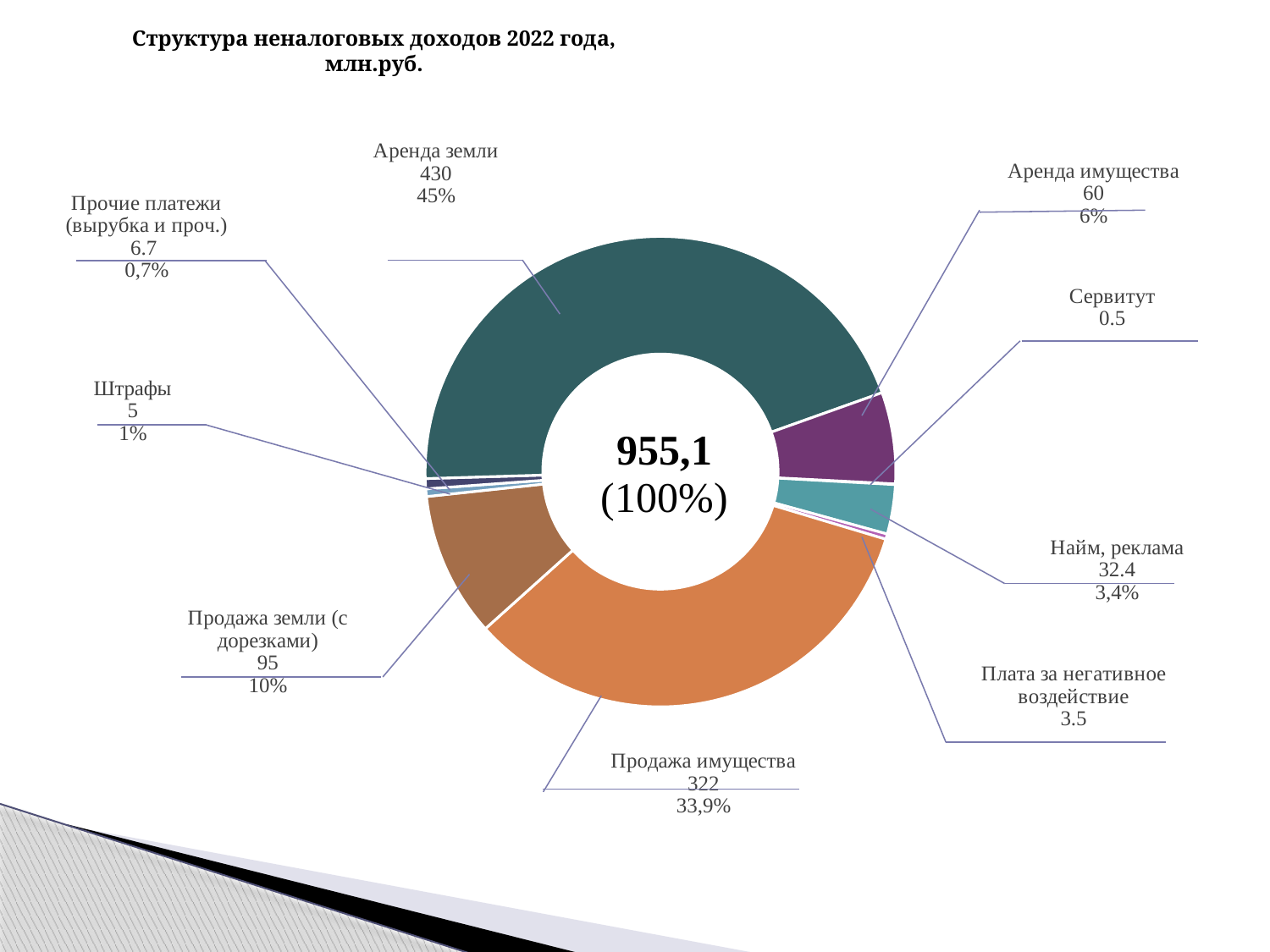
Which is larger, the value for Штрафы or the value for Прочие платежи (вырубка и проч.)? Прочие платежи (вырубка и проч.) Which category has the smallest value? Сервитут What is the value for Продажа имущества? 322 What share of the total does Аренда имущества represent? 6% What is the value for Найм, реклама? 32.4 What share of the total does Продажа земли (с дорезками) represent? 10% What is the value for Аренда земли? 430 What is the value for Плата за негативное воздействие? 3.5 What type of chart is shown on the slide? Doughnut (pie) chart How many categories does the chart show? 9 What is the difference between the values for Аренда земли and Продажа имущества? 108 Which category has the largest value? Аренда земли